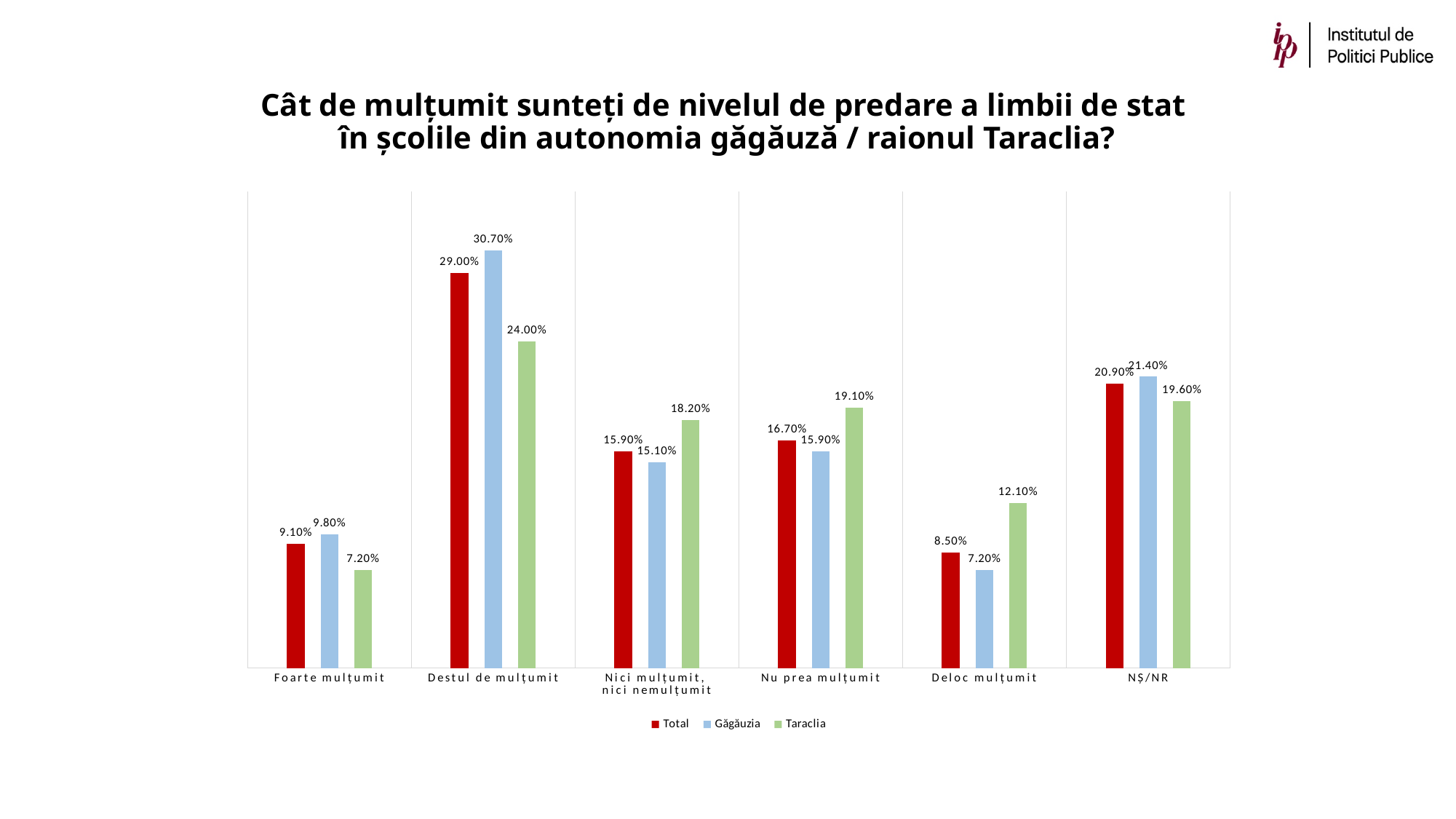
Which category has the highest Găgăuzia value? Destul de mulțumit What is the Taraclia value for "Nu prea mulțumit"? 19.10% What kind of chart is shown on the slide? Bar chart What is the Total value for "Destul de mulțumit"? 29.00% How many categories are shown on the x axis? 6 What is the Găgăuzia value for "Deloc mulțumit"? 7.20% Which category has the lowest Taraclia value? Foarte mulțumit For "Nici mulțumit, nici nemulțumit", which is larger: the Total value or the Taraclia value? Taraclia How many series does the legend list? 3 What is the Total value for "NȘ/NR"? 20.90% What is the difference between the Găgăuzia and Taraclia values for "Destul de mulțumit"? 6.70% What is the difference between the Taraclia and Total values for "Deloc mulțumit"? 3.60%